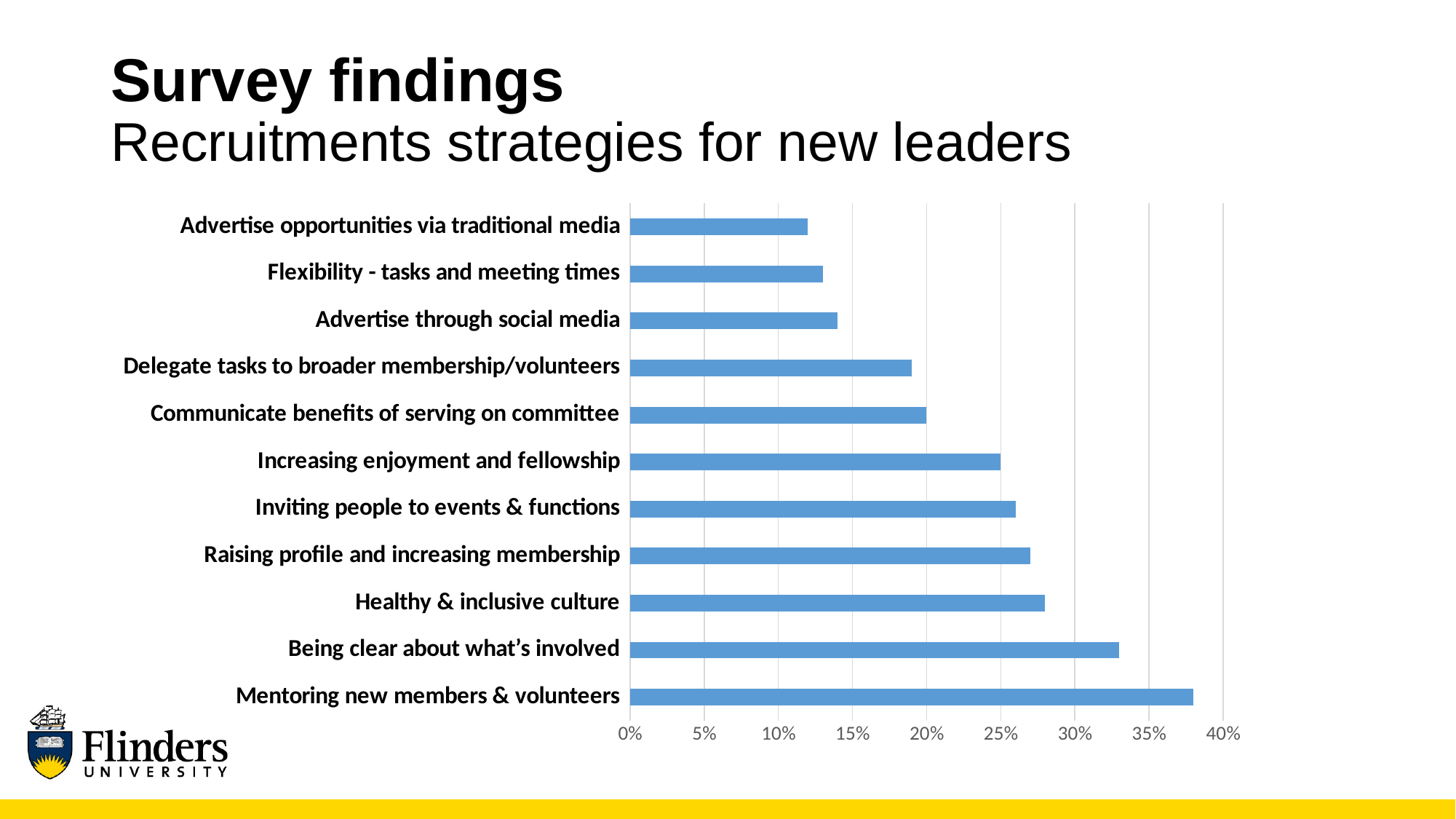
Is the value for Advertise opportunities via traditional media greater or less than 15%? less What kind of chart is shown on the slide? bar chart Which is larger: the value for Being clear about what's involved or the value for Healthy & inclusive culture? Being clear about what's involved Is the value for Being clear about what's involved greater or less than 30%? greater Which is larger: the value for Delegate tasks to broader membership/volunteers or the value for Advertise through social media? Delegate tasks to broader membership/volunteers Which recruitment strategy has the highest value in the chart? Mentoring new members & volunteers Is the value for Raising profile and increasing membership greater or less than 25%? greater What is the highest value shown on the chart's horizontal axis? 40% How many recruitment strategies (categories) are plotted in the chart? 11